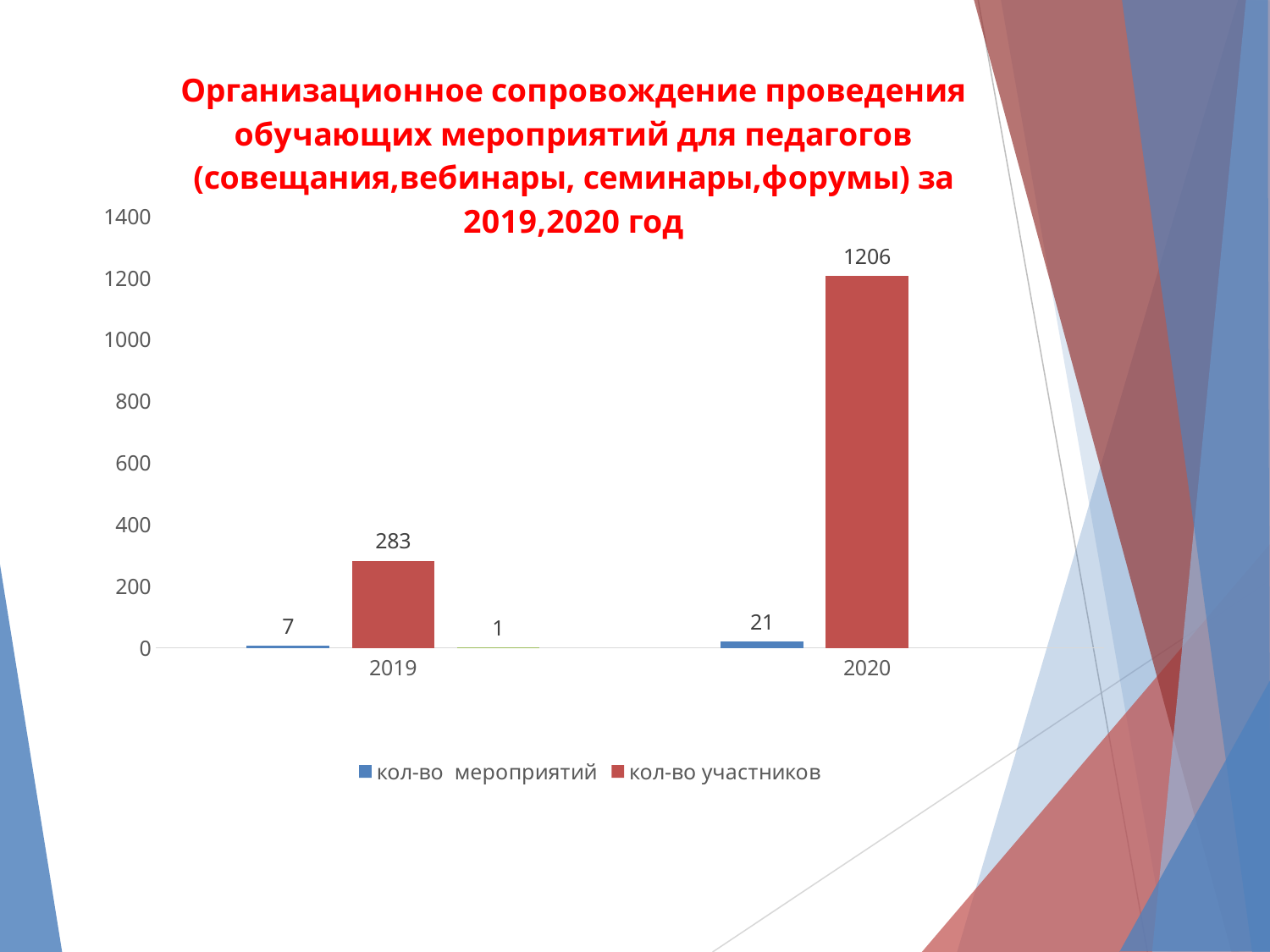
What kind of chart is shown on the slide? bar chart What colour are the bars for кол-во участников? red What is the value of кол-во участников for 2019? 283 Which year has the higher value for кол-во участников, 2019 or 2020? 2020 What is the difference in кол-во мероприятий between 2020 and 2019? 14 What is the value of кол-во участников for 2020? 1206 Do the values for кол-во участников rise or fall from 2019 to 2020? rise What is the value of кол-во мероприятий for 2019? 7 By how much did кол-во участников increase from 2019 to 2020? 923 How many series does the legend list? 2 Is the value for кол-во участников in 2020 greater or less than 1000? greater What is the value of кол-во мероприятий for 2020? 21